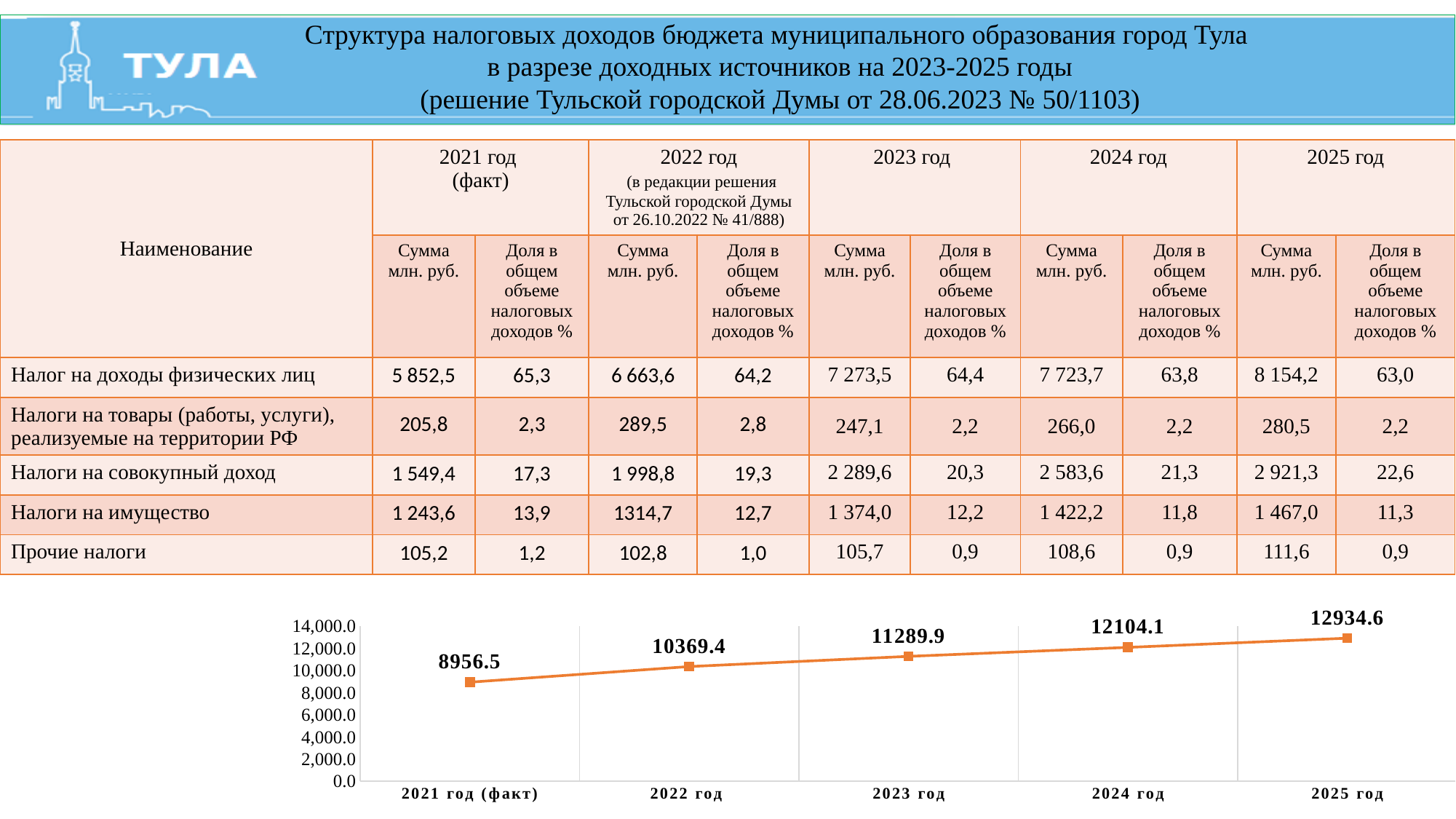
What type of chart is shown at the bottom of the slide? line chart In the line chart, what is the difference between the values for 2022 год and 2021 год (факт)? 1412.9 In the line chart, what is the difference between the values for 2025 год and 2021 год (факт)? 3978.1 In the line chart, which year has the highest value? 2025 год In the line chart, which year has the lowest value? 2021 год (факт) In the line chart, what is the value for 2023 год? 11289.9 In the line chart, which is larger: the value for 2024 год or the value for 2022 год? 2024 год In the line chart, what is the value for 2021 год (факт)? 8956.5 How many data points are plotted in the line chart? 5 In the line chart, what is the value for 2025 год? 12934.6 In the line chart, is the value for 2023 год greater or less than 10,000.0? greater Do the values in the line chart rise or fall from 2021 to 2025? rise